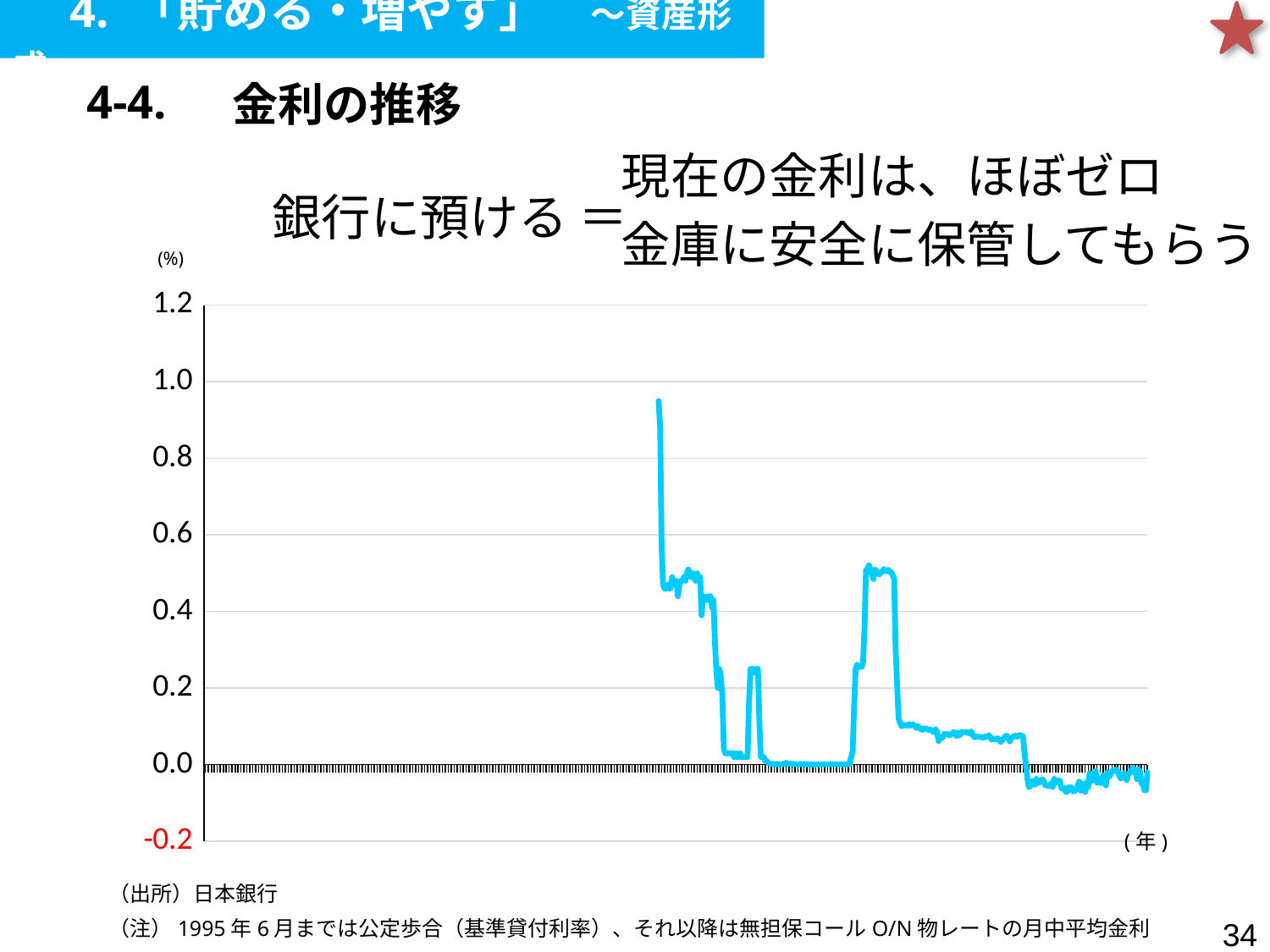
Is the highest value reached by the line greater or less than 1.0? less Overall, does the line rise or fall from left to right along the x axis? fall What is the title of the chart section on the slide? 4-4. 金利の推移 What is the highest tick value shown on the vertical axis? 1.2 Is the highest value reached by the line greater or less than 0.8? greater Is the value at the right end of the line greater or less than 0.0? less How many lines are plotted on the chart? 1 What is the lowest tick value shown on the vertical axis? -0.2 What kind of chart is shown on the slide? line chart What is the source of the data cited below the chart? 日本銀行 What unit is shown on the vertical axis of the chart? %